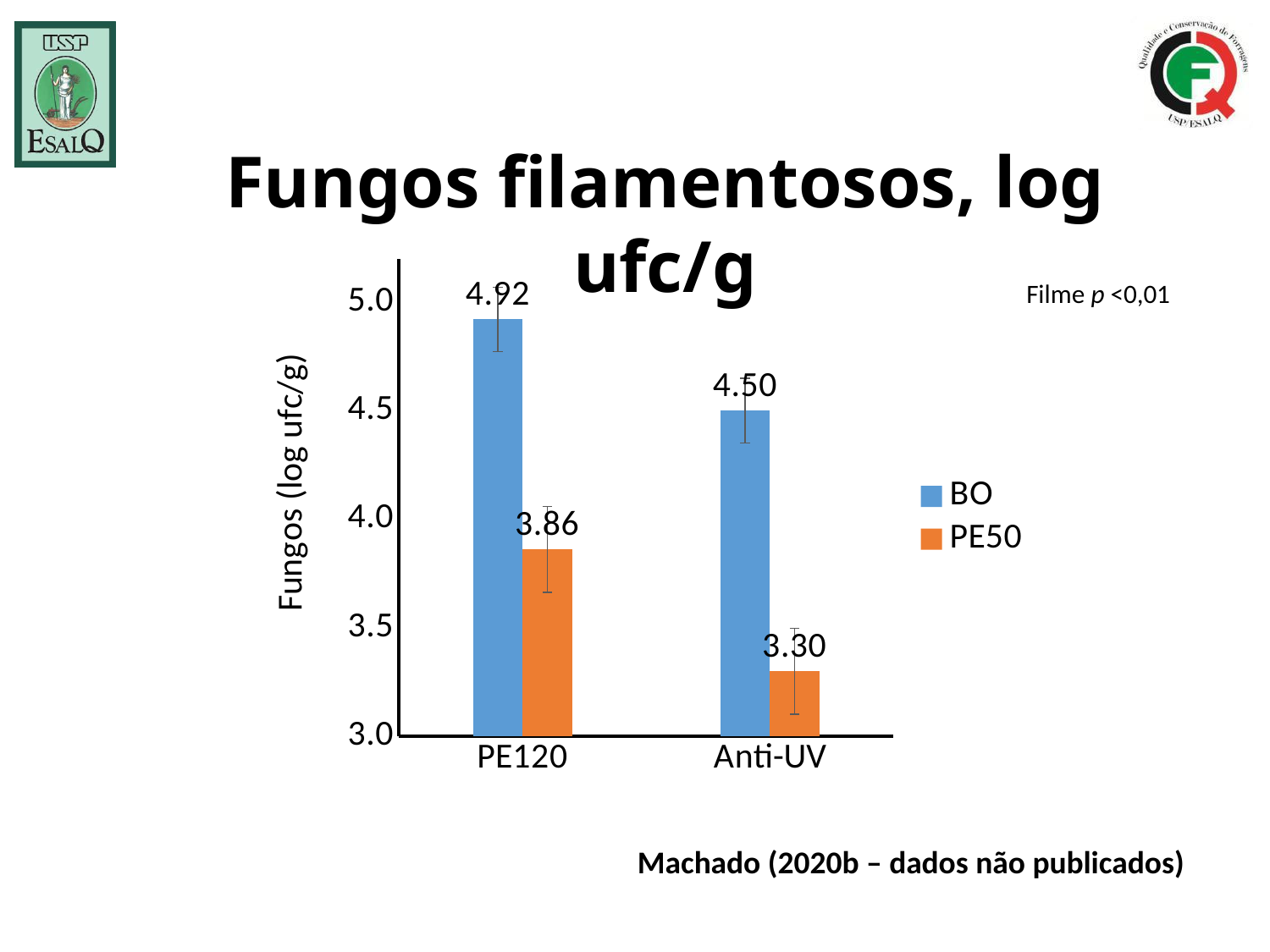
Which bar has the highest value on the chart? BO in PE120 Which is larger, the PE50 value for PE120 or the PE50 value for Anti-UV? PE50 for PE120 What is the value for BO in the Anti-UV category? 4.50 Which bar has the lowest value on the chart? PE50 in Anti-UV How many categories are shown on the x axis? 2 What kind of chart is shown on the slide? Bar chart What is the value for BO in the PE120 category? 4.92 What is the value for PE50 in the PE120 category? 3.86 How many series does the legend list? 2 What is the difference between the BO and PE50 values in the PE120 category? 1.06 What is the difference between the BO values for PE120 and Anti-UV? 0.42 What is the value for PE50 in the Anti-UV category? 3.30